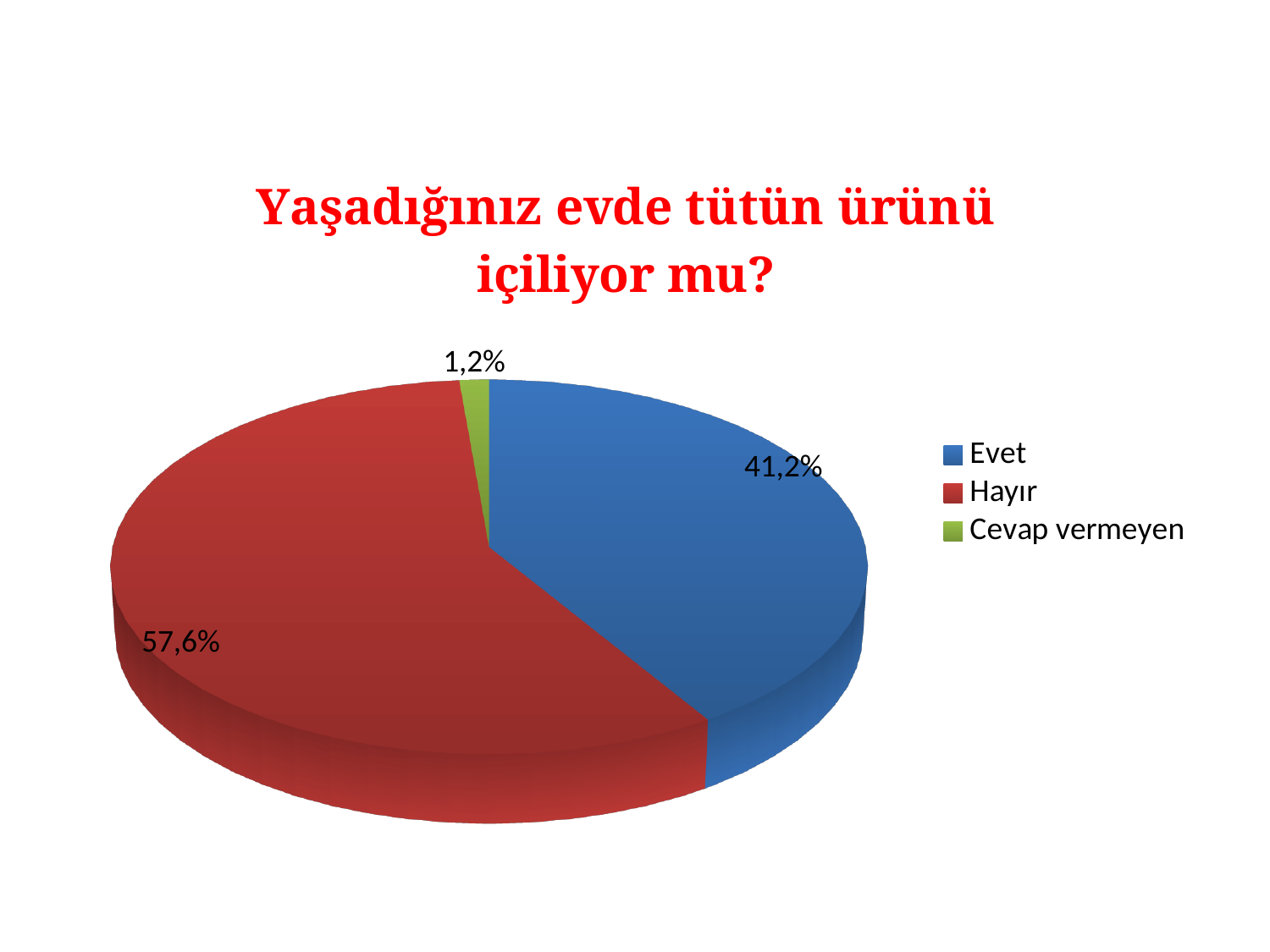
Which category has the largest share of the pie? Hayır How many categories does the pie chart have? 3 What is the value for Cevap vermeyen? 1,2% Which category has the smallest share of the pie? Cevap vermeyen What kind of chart is shown on the slide? pie chart What is the title of the chart? Yaşadığınız evde tütün ürünü içiliyor mu? What is the value for Evet? 41,2% What is the value for Hayır? 57,6% Which colour represents Cevap vermeyen in the legend? green Which is larger, the value for Evet or the value for Hayır? Hayır What is the difference between the values for Evet and Cevap vermeyen? 40,0% What is the difference between the values for Hayır and Evet? 16,4%